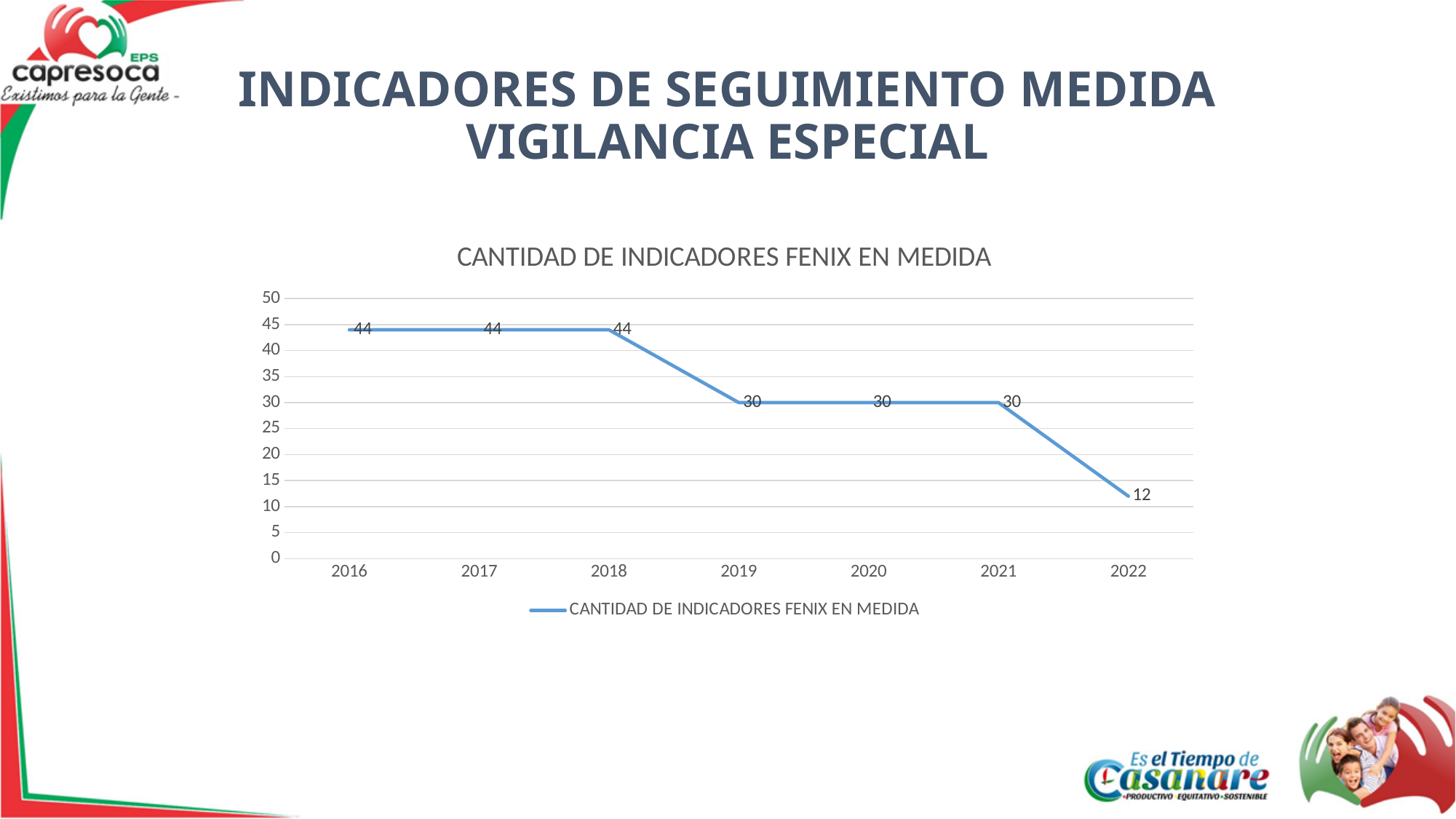
What is the difference between the values for 2021 and 2022? 18 Which is larger, the value for 2017 or the value for 2020? 2017 Is the value for 2022 greater or less than 15? less How many years are plotted on the x axis? 7 Which year has the lowest value? 2022 What is the difference between the values for 2018 and 2019? 14 How many series does the legend list? 1 Do the values rise or fall from 2016 to 2022? fall What is the value for 2016? 44 What is the value for 2022? 12 What kind of chart is shown? line chart What is the value for 2019? 30